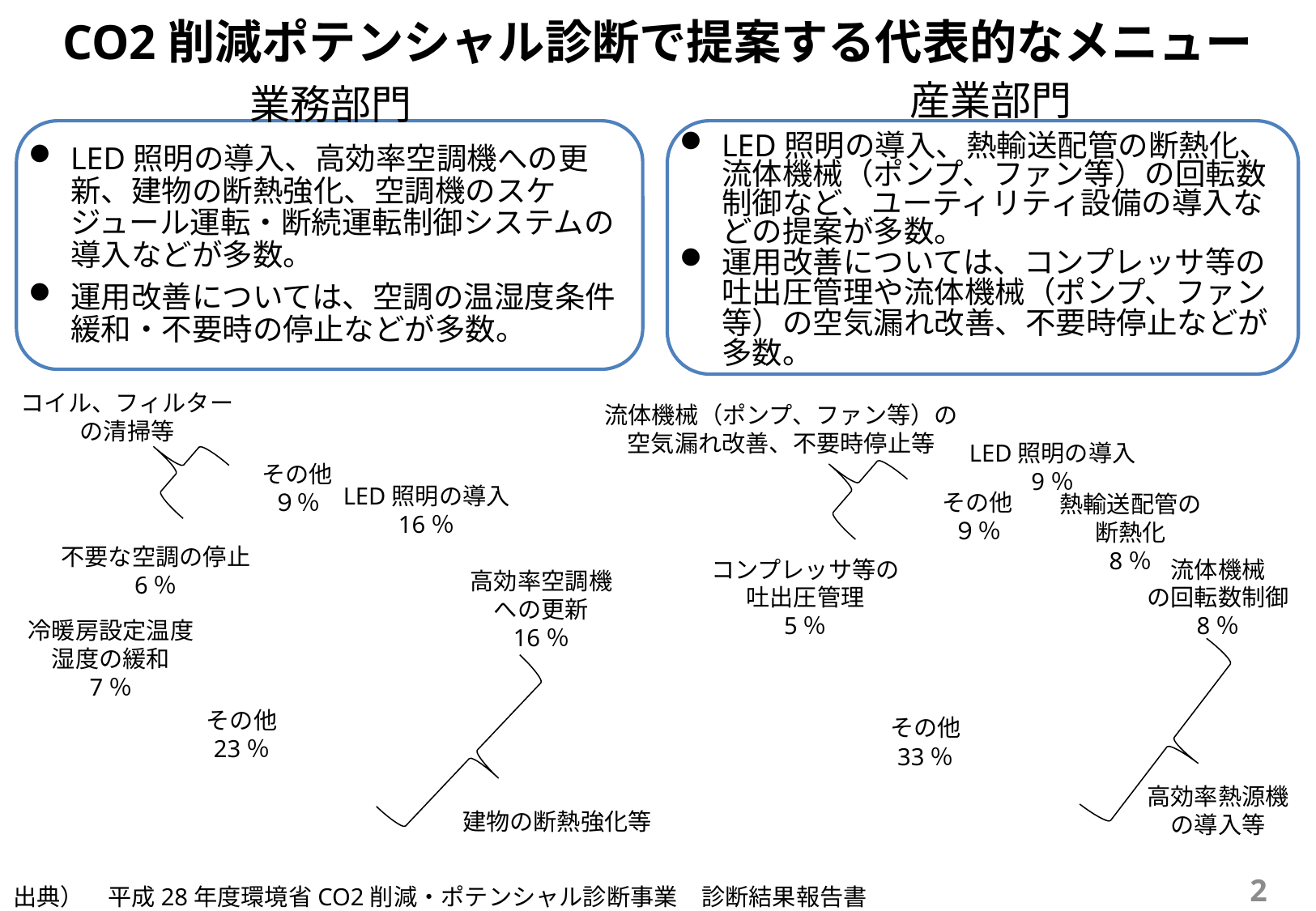
In the left chart (業務部門), what percentage is shown for 冷暖房設定温度湿度の緩和? 7 % In the left chart (業務部門), which labeled category has the largest percentage? その他 (23 %) In the right chart (産業部門), what percentage is shown for コンプレッサ等の吐出圧管理? 5 % In the right chart (産業部門), which is larger: 流体機械の回転数制御 or コンプレッサ等の吐出圧管理? 流体機械の回転数制御 In the left chart (業務部門), what percentage is shown for 高効率空調機への更新? 16 % In the right chart (産業部門), what percentage is shown for 熱輸送配管の断熱化? 8 % In the left chart (業務部門), what percentage is shown for 不要な空調の停止? 6 % Comparing the two charts, which sector shows a higher percentage for LED 照明の導入, 業務部門 or 産業部門? 業務部門 In the left chart (業務部門), what is the difference between the percentages for 高効率空調機への更新 and 不要な空調の停止? 10 % In the left chart (業務部門), what percentage is shown for LED 照明の導入? 16 % In the right chart (産業部門), what percentage is shown for LED 照明の導入? 9 %